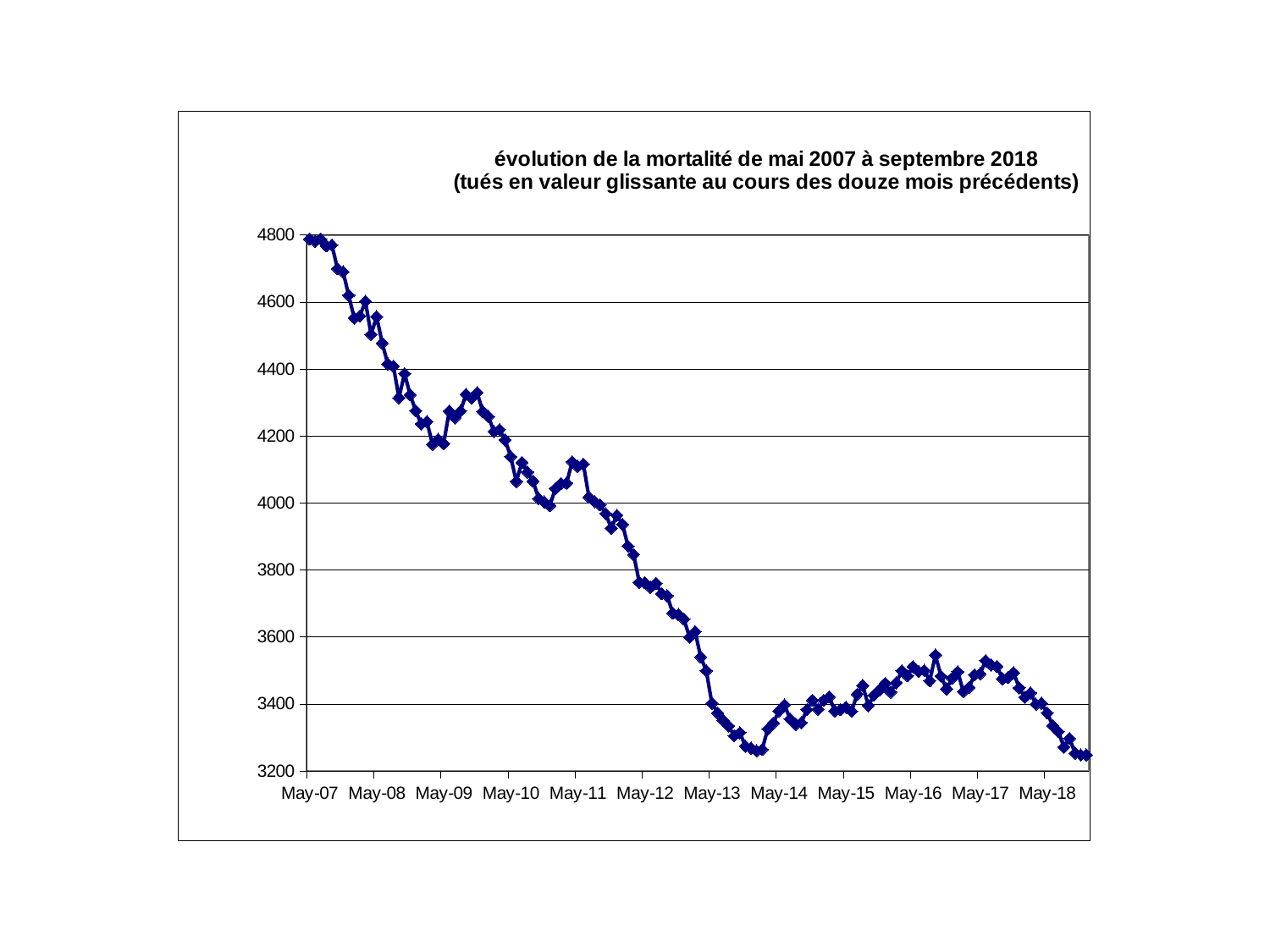
Is the value at May-09 greater or less than 4400? less Which is larger, the value at May-11 or the value at May-14? May-11 What kind of chart is shown on the slide? line chart Overall, does the line rise or fall from May-07 to May-18? fall Is the value at May-12 greater or less than 4000? less Is the value at May-14 greater or less than 3600? less How many labels are shown on the x axis? 12 What is the title of the chart? évolution de la mortalité de mai 2007 à septembre 2018 (tués en valeur glissante au cours des douze mois précédents) Which x-axis label corresponds to the highest point on the line? May-07